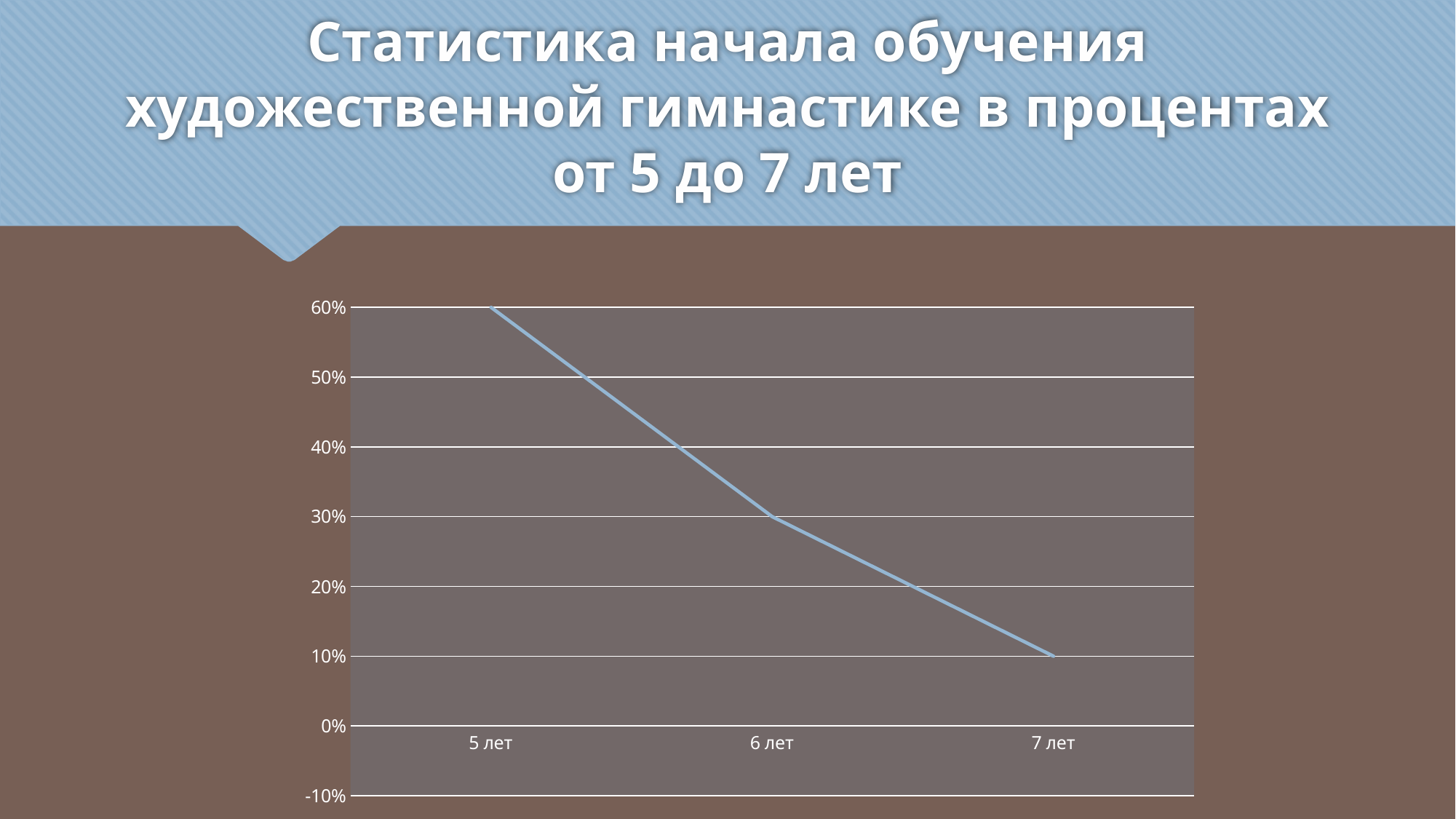
Do the values rise or fall from 5 лет to 7 лет? fall Which is larger, the value for 5 лет or the value for 7 лет? 5 лет What type of chart is shown on the slide? line chart What is the value for 6 лет? 30% What is the difference between the values for 6 лет and 7 лет? 20% Which age category has the highest value? 5 лет What is the difference between the values for 5 лет and 6 лет? 30% What is the value for 5 лет? 60% How many age categories are plotted on the x axis? 3 What is the value for 7 лет? 10% What is the title of the slide containing the chart? Статистика начала обучения художественной гимнастике в процентах от 5 до 7 лет Which age category has the lowest value? 7 лет